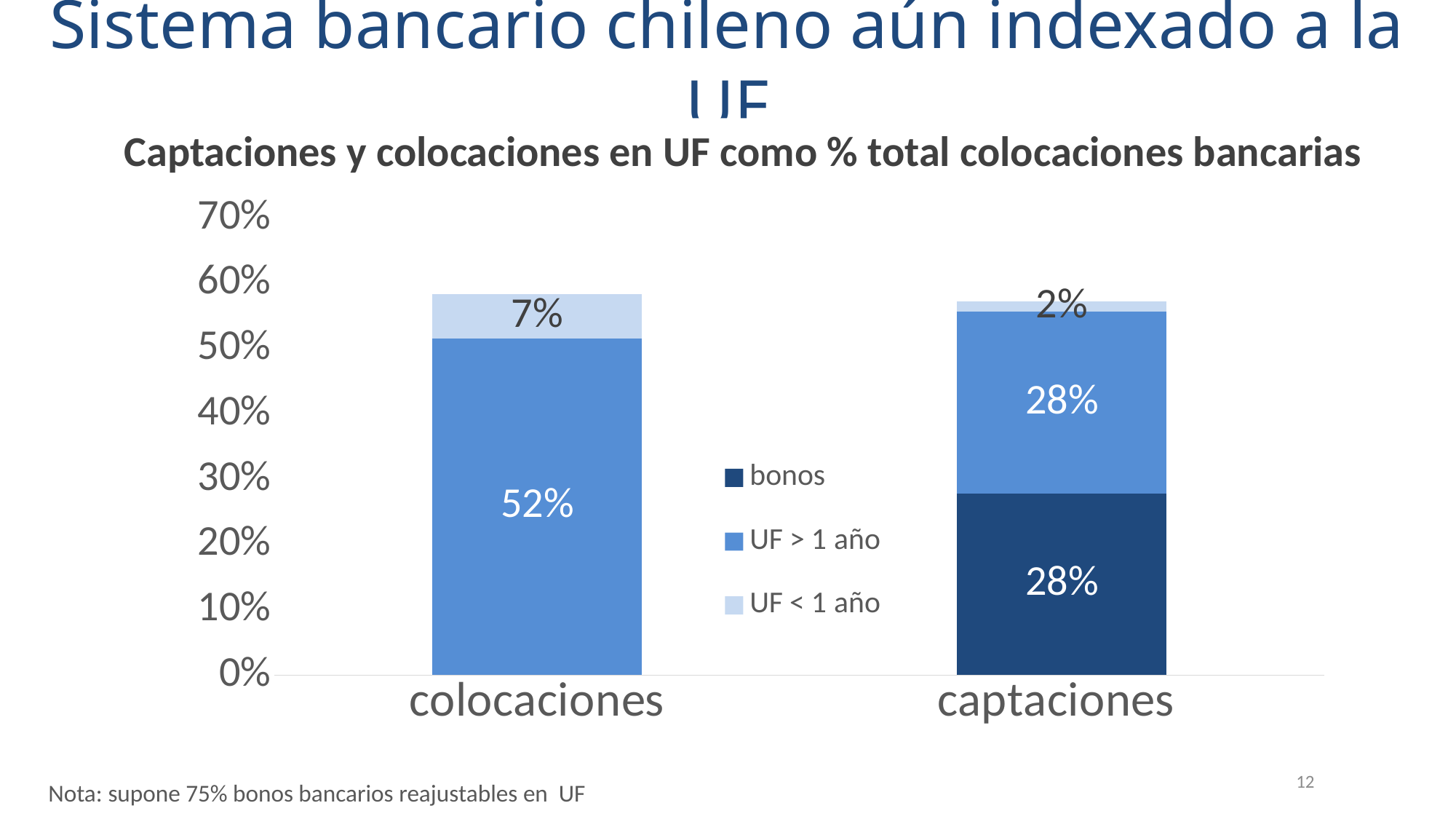
What is the value of the 'UF > 1 año' segment for colocaciones? 52% Which category has the larger 'UF < 1 año' segment, colocaciones or captaciones? colocaciones What kind of chart is shown on the slide? Stacked bar chart What is the value of the 'UF < 1 año' segment for captaciones? 2% What is the value of the 'UF > 1 año' segment for captaciones? 28% What is the difference between the 'UF > 1 año' values for colocaciones and captaciones? 24 percentage points How many categories are shown on the x axis? 2 How many series does the legend list? 3 What is the title of the chart? Captaciones y colocaciones en UF como % total colocaciones bancarias What is the value of the 'UF < 1 año' segment for colocaciones? 7% What is the value of the 'bonos' segment for captaciones? 28% What is the total of the stacked bar for captaciones? 58%